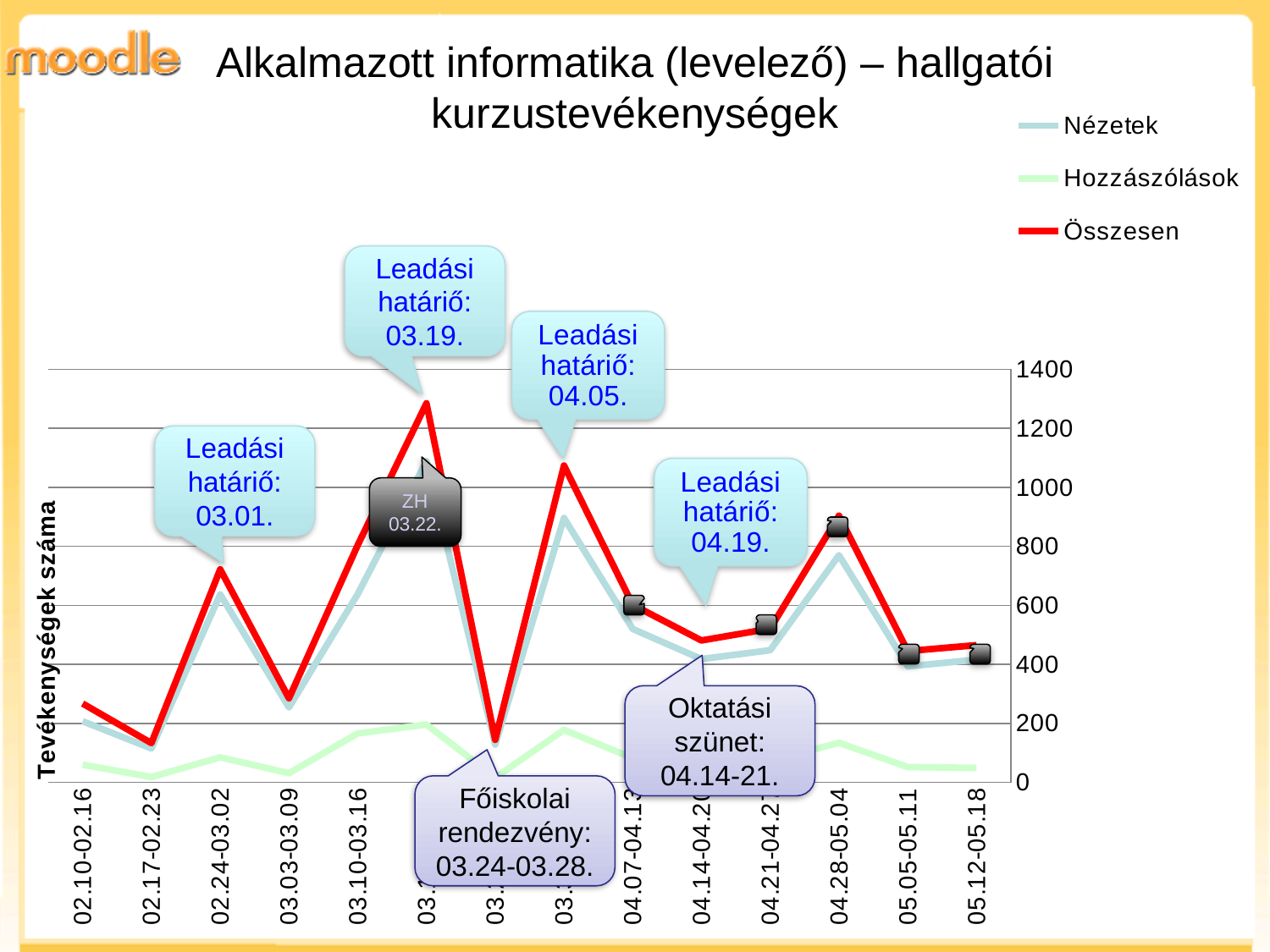
Does the Összesen line rise or fall from 04.28-05.04 to 05.05-05.11? fall Is the Nézetek value for 02.17-02.23 greater or less than 200? less Is the Összesen value for 04.28-05.04 greater or less than 800? greater How many weekly periods are plotted along the x axis? 14 Is the Összesen value for 02.17-02.23 greater or less than 200? less Which series is drawn with the red line? Összesen How many series does the legend list? 3 What kind of chart is shown on the slide? line chart What is the title of the vertical axis? Tevékenységek száma Which has the larger Összesen value, 02.24-03.02 or 04.28-05.04? 04.28-05.04